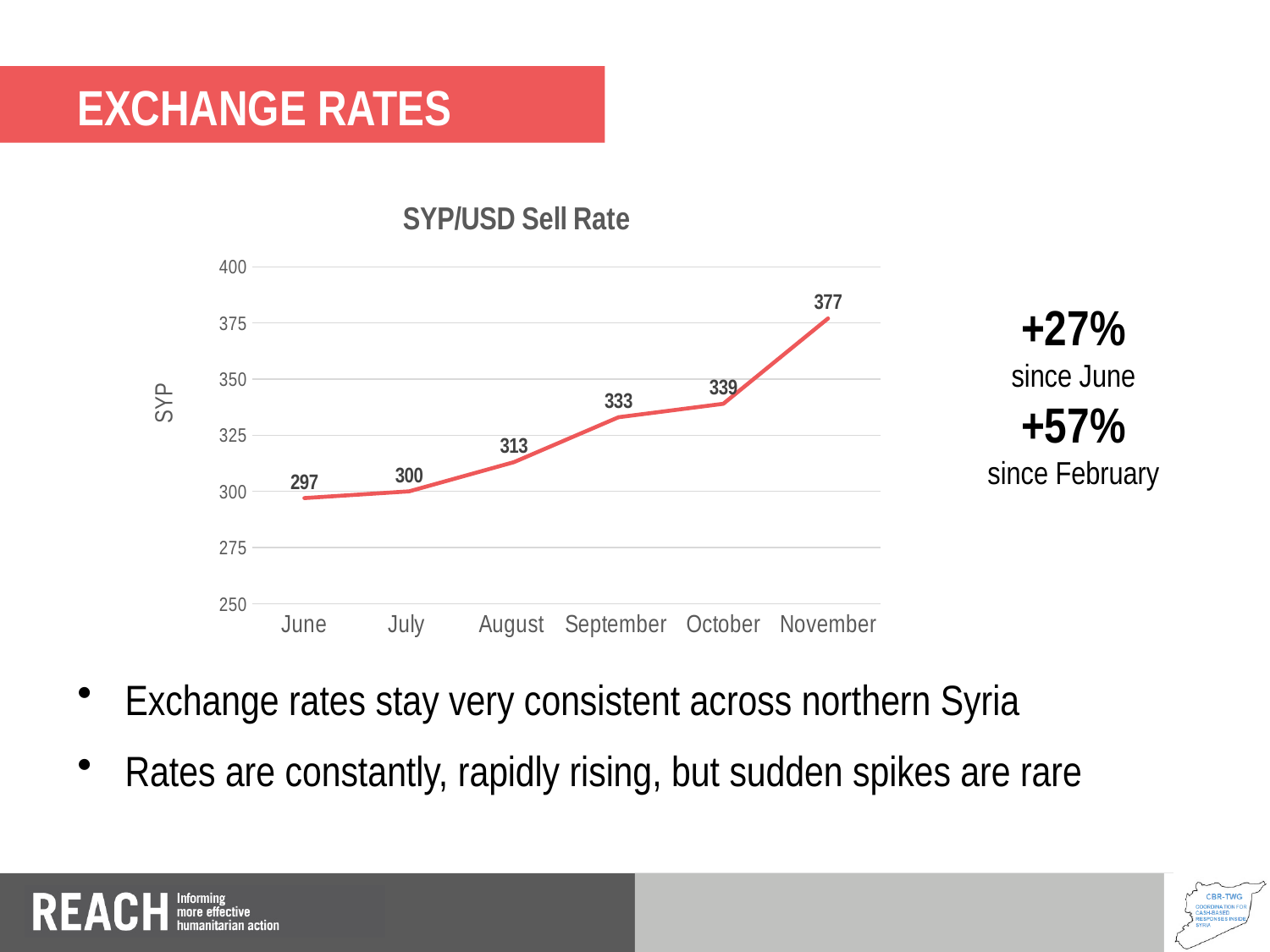
Which month has the lowest SYP/USD sell rate? June Which is larger, the sell rate in August or in October? October What is the difference between the November and June sell rates? 80 Is the sell rate for November greater or less than 350? greater How many months are plotted on the chart? 6 Do the sell rates rise or fall from June to November? rise What is the SYP/USD sell rate for September? 333 What kind of chart is shown on the slide? line chart What is the SYP/USD sell rate for June? 297 What is the difference between the October and September sell rates? 6 What is the SYP/USD sell rate for November? 377 Which month has the highest SYP/USD sell rate? November